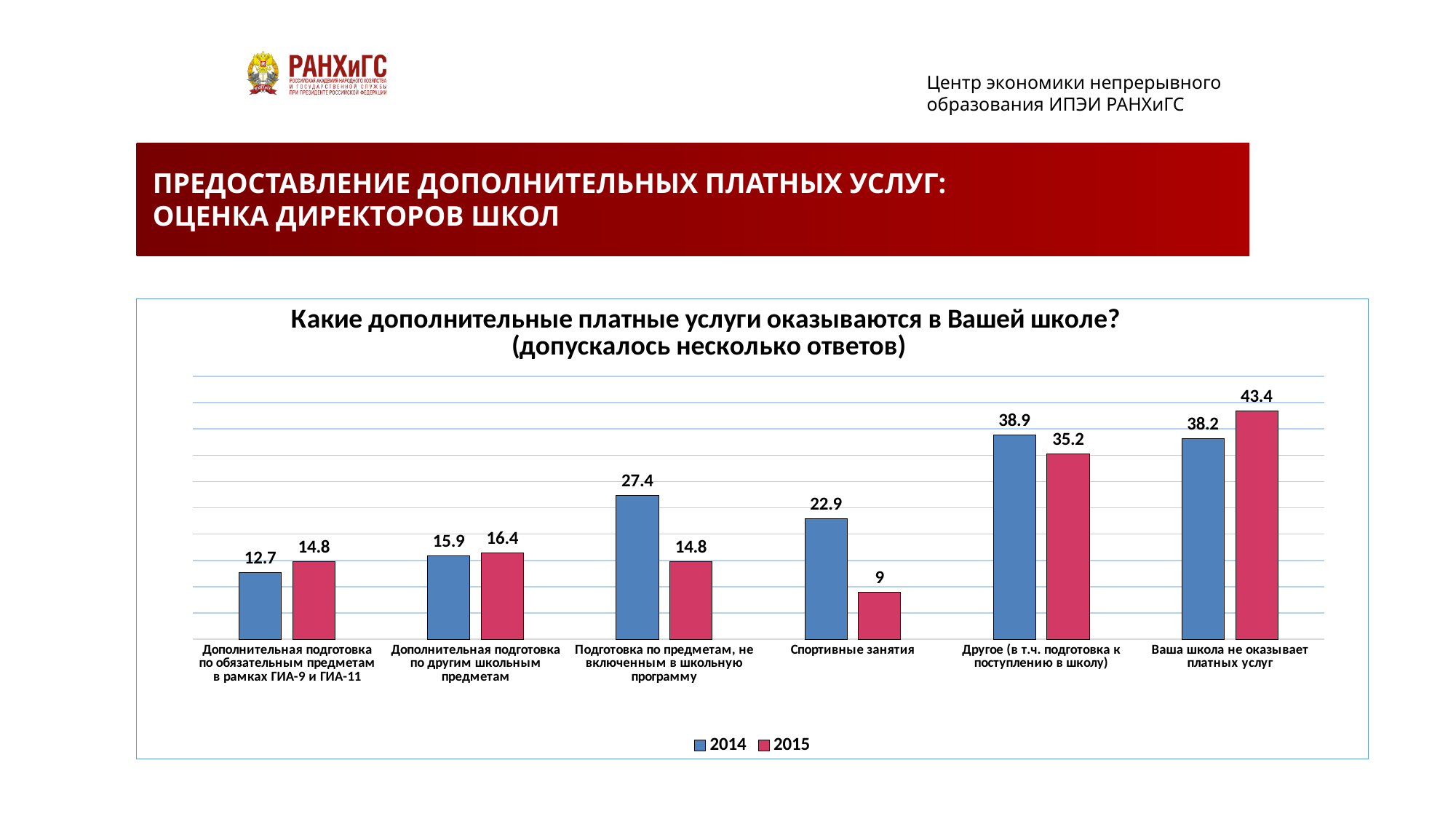
What is the 2014 value for «Дополнительная подготовка по обязательным предметам в рамках ГИА-9 и ГИА-11»? 12.7 What kind of chart is shown on the slide? Bar chart Which category has the lowest 2015 value? Спортивные занятия How many series does the legend list? 2 What is the 2014 value for «Подготовка по предметам, не включенным в школьную программу»? 27.4 What is the 2015 value for «Спортивные занятия»? 9 Which series is shown in red? 2015 What is the 2015 value for «Ваша школа не оказывает платных услуг»? 43.4 What is the difference between the 2014 and 2015 values for «Спортивные занятия»? 13.9 Which is larger for «Другое (в т.ч. подготовка к поступлению в школу)»: the 2014 value or the 2015 value? 2014 How many categories are shown on the x axis? 6 Which category has the highest 2014 value? Другое (в т.ч. подготовка к поступлению в школу)